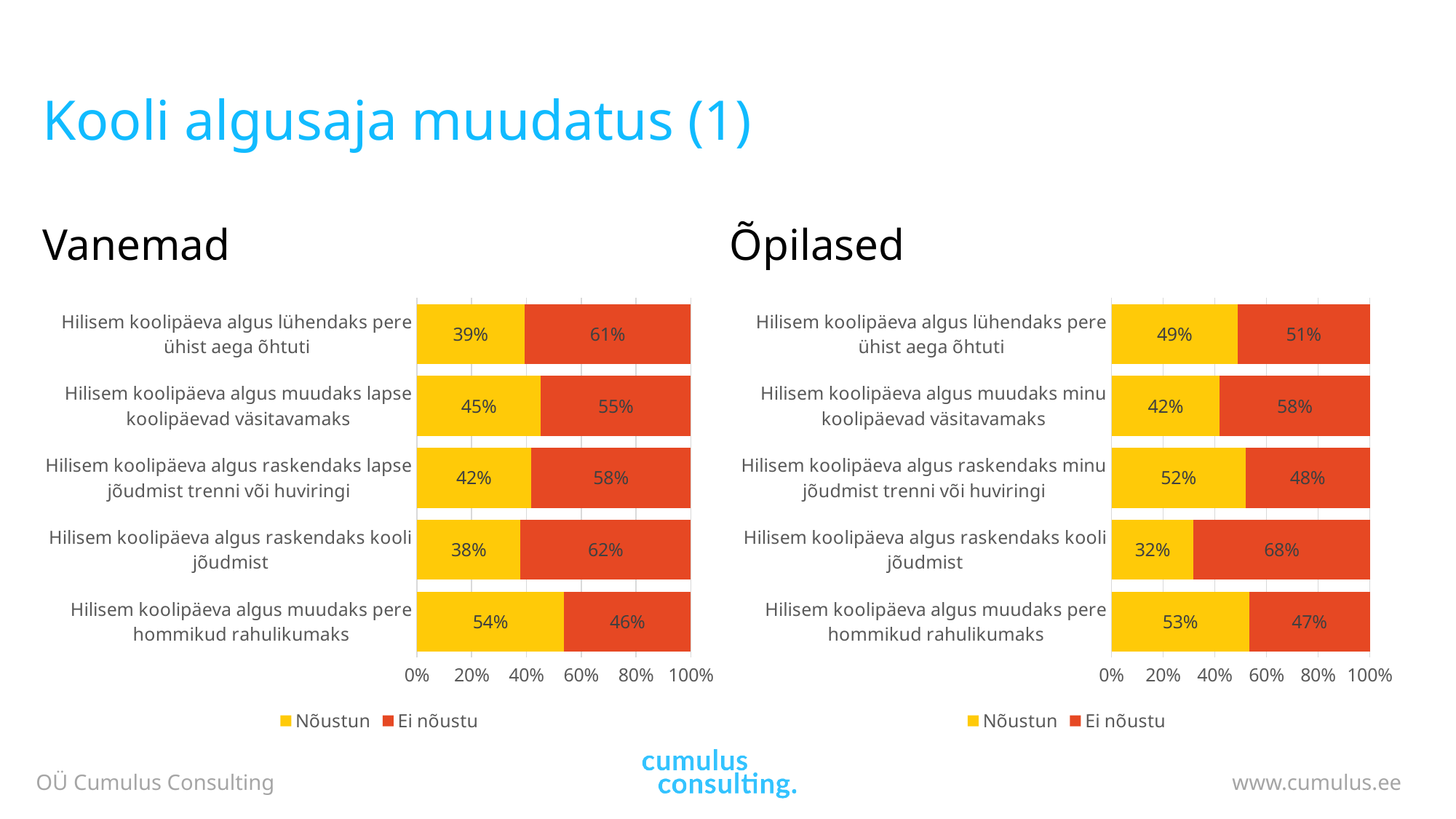
In the Vanemad chart, what percentage of parents agree (Nõustun) that a later school day start would make family mornings calmer (Hilisem koolipäeva algus muudaks pere hommikud rahulikumaks)? 54% In the Vanemad chart, what is the difference between the Ei nõustu and Nõustun values for 'Hilisem koolipäeva algus raskendaks kooli jõudmist'? 24% In the Õpilased chart, which statement has the lowest Nõustun share? Hilisem koolipäeva algus raskendaks kooli jõudmist What type of chart is the Vanemad chart? Stacked bar chart In the Õpilased chart, what is the total of the Nõustun and Ei nõustu values for 'Hilisem koolipäeva algus muudaks minu koolipäevad väsitavamaks'? 100% For the statement 'Hilisem koolipäeva algus raskendaks kooli jõudmist', which chart shows the larger Nõustun value, Vanemad or Õpilased? Vanemad In the Õpilased chart, what is the Nõustun value for 'Hilisem koolipäeva algus lühendaks pere ühist aega õhtuti'? 49% How many series does the legend of the Õpilased chart list? 2 How many statements (categories) are shown in the Vanemad chart? 5 In the Õpilased chart, what is the Ei nõustu value for 'Hilisem koolipäeva algus raskendaks kooli jõudmist'? 68% What colour represents the Ei nõustu series in both charts? Red In the Vanemad chart, which statement has the highest Nõustun share? Hilisem koolipäeva algus muudaks pere hommikud rahulikumaks